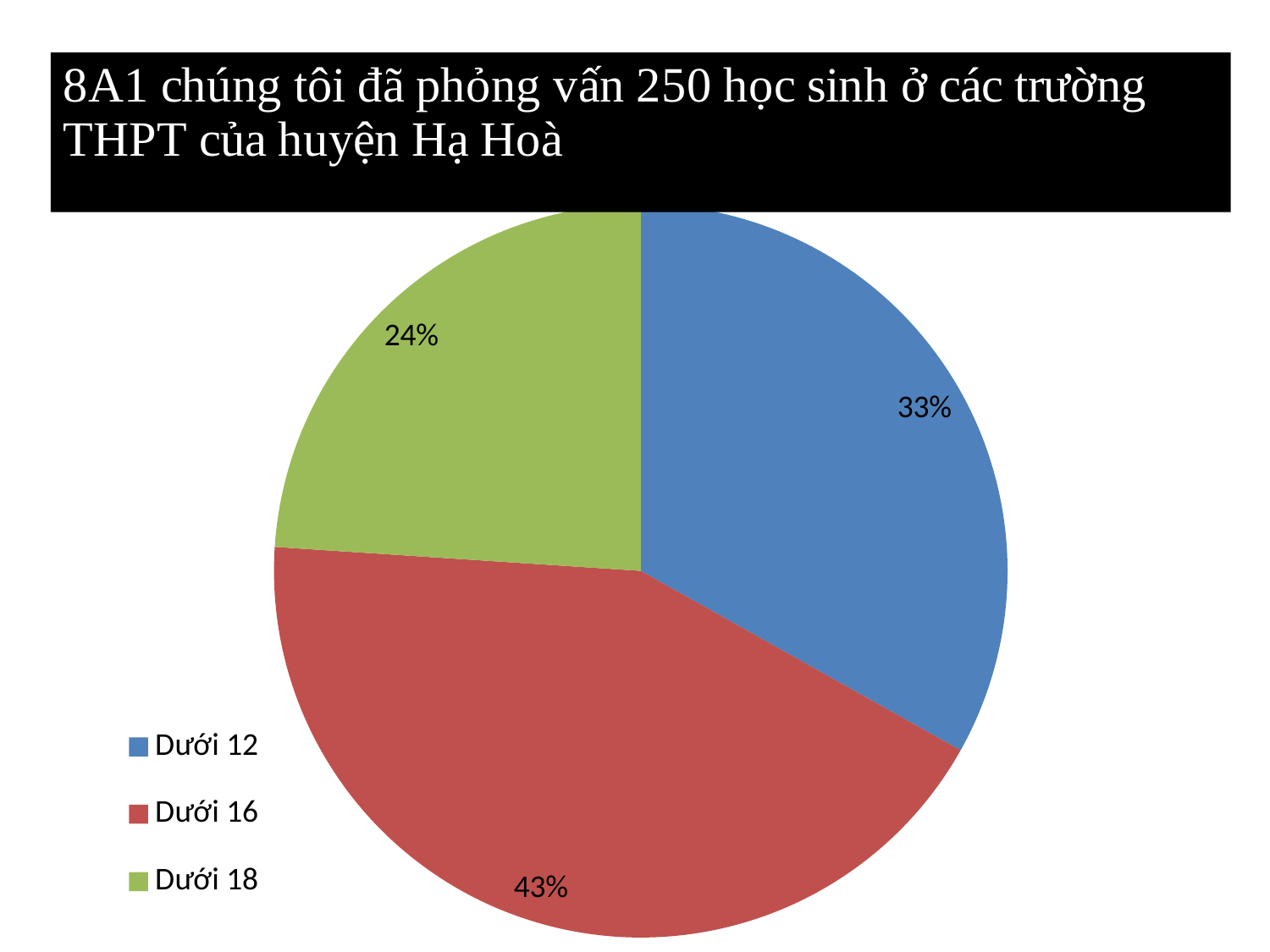
What colour is the slice for "Dưới 16"? red Which category has the largest slice of the pie? Dưới 16 What is the difference in percentage points between "Dưới 16" and "Dưới 12"? 10% What share of the pie does "Dưới 18" have? 24% What share of the pie does "Dưới 16" have? 43% Which category has the smallest slice of the pie? Dưới 18 How many categories does the pie chart have? 3 What share of the pie does "Dưới 12" have? 33% Which is larger, the slice for "Dưới 12" or the slice for "Dưới 18"? Dưới 12 What kind of chart is shown on the slide? pie chart What is the difference in percentage points between "Dưới 12" and "Dưới 18"? 9% Which category is shown in green in the legend? Dưới 18